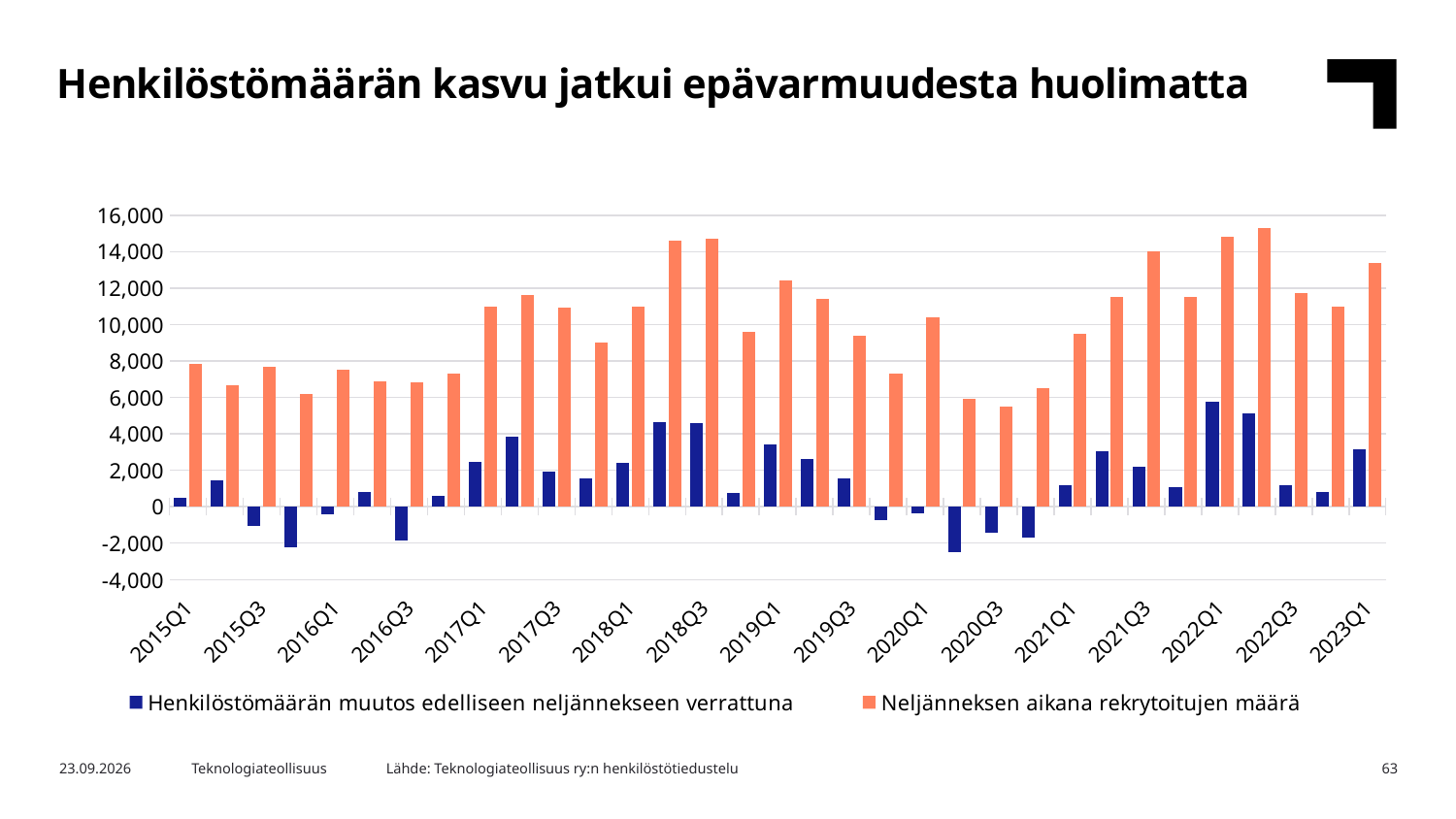
Is the value of Neljänneksen aikana rekrytoitujen määrä for 2015Q1 greater or less than 10,000? less How many series does the legend list? 2 Which is larger for Henkilöstömäärän muutos edelliseen neljännekseen verrattuna: 2017Q3 or 2019Q1? 2019Q1 Is the value of Henkilöstömäärän muutos edelliseen neljännekseen verrattuna for 2020Q3 greater or less than 0? less Is the value of Henkilöstömäärän muutos edelliseen neljännekseen verrattuna for 2022Q1 greater or less than 4,000? greater Which is larger for Neljänneksen aikana rekrytoitujen määrä: 2018Q3 or 2015Q3? 2018Q3 What is the title of the slide? Henkilöstömäärän kasvu jatkui epävarmuudesta huolimatta What kind of chart is shown on the slide? bar chart Does the value of Neljänneksen aikana rekrytoitujen määrä rise or fall from 2020Q3 to 2022Q1? rise Which series is shown in orange? Neljänneksen aikana rekrytoitujen määrä